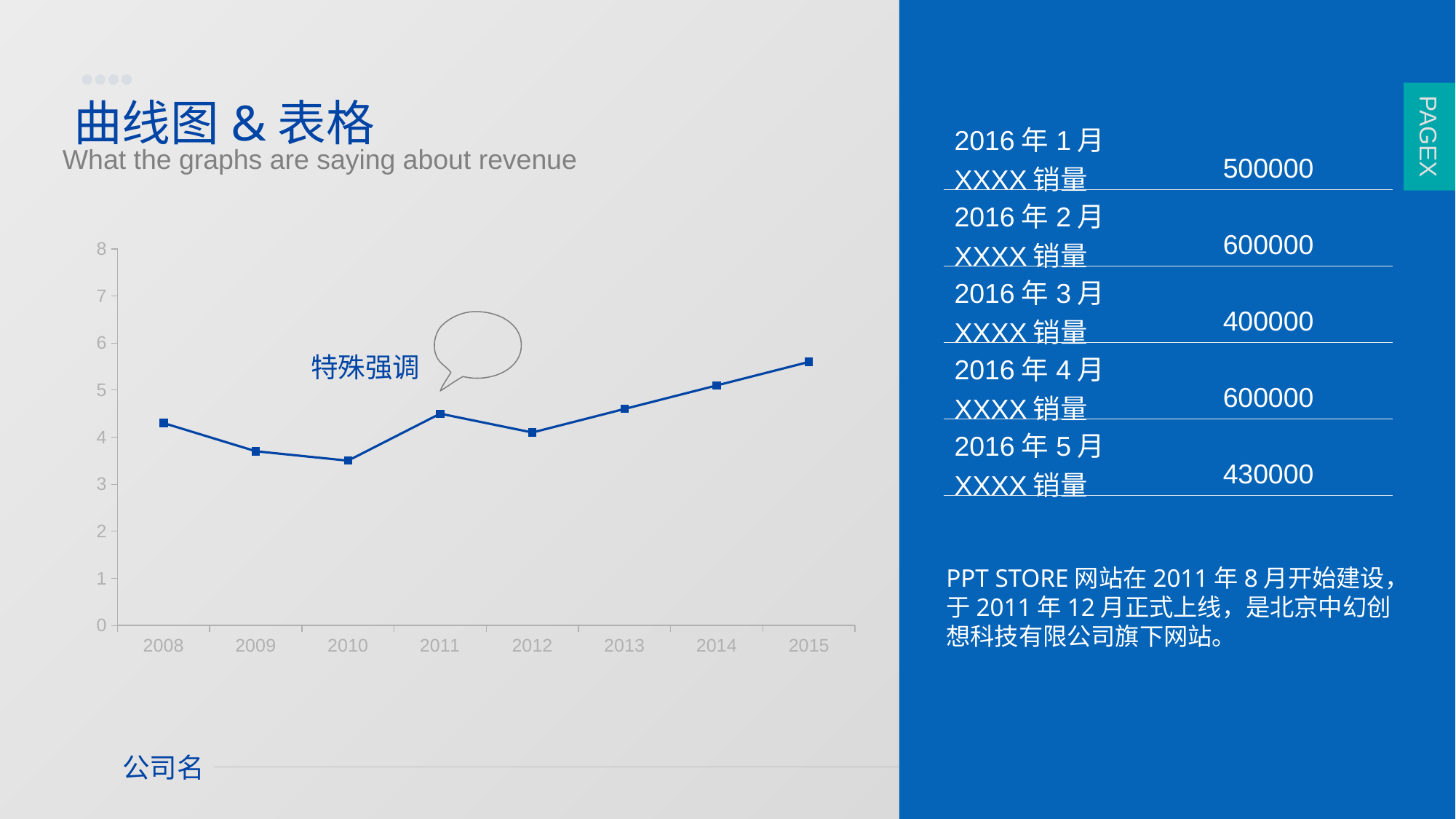
Which year has the lowest value on the line chart? 2010 Do the values rise or fall from 2008 to 2010? fall Is the value for 2010 greater or less than 4? less Which is larger, the value for 2011 or the value for 2012? 2011 Is the value for 2011 greater or less than 4? greater Is the value for 2015 greater or less than 5? greater How many data points are plotted on the line chart? 8 Do the values rise or fall from 2012 to 2015? rise Which year's data point does the callout labelled 特殊强调 point to? 2011 What kind of chart is shown on the slide? line chart Which year has the highest value on the line chart? 2015